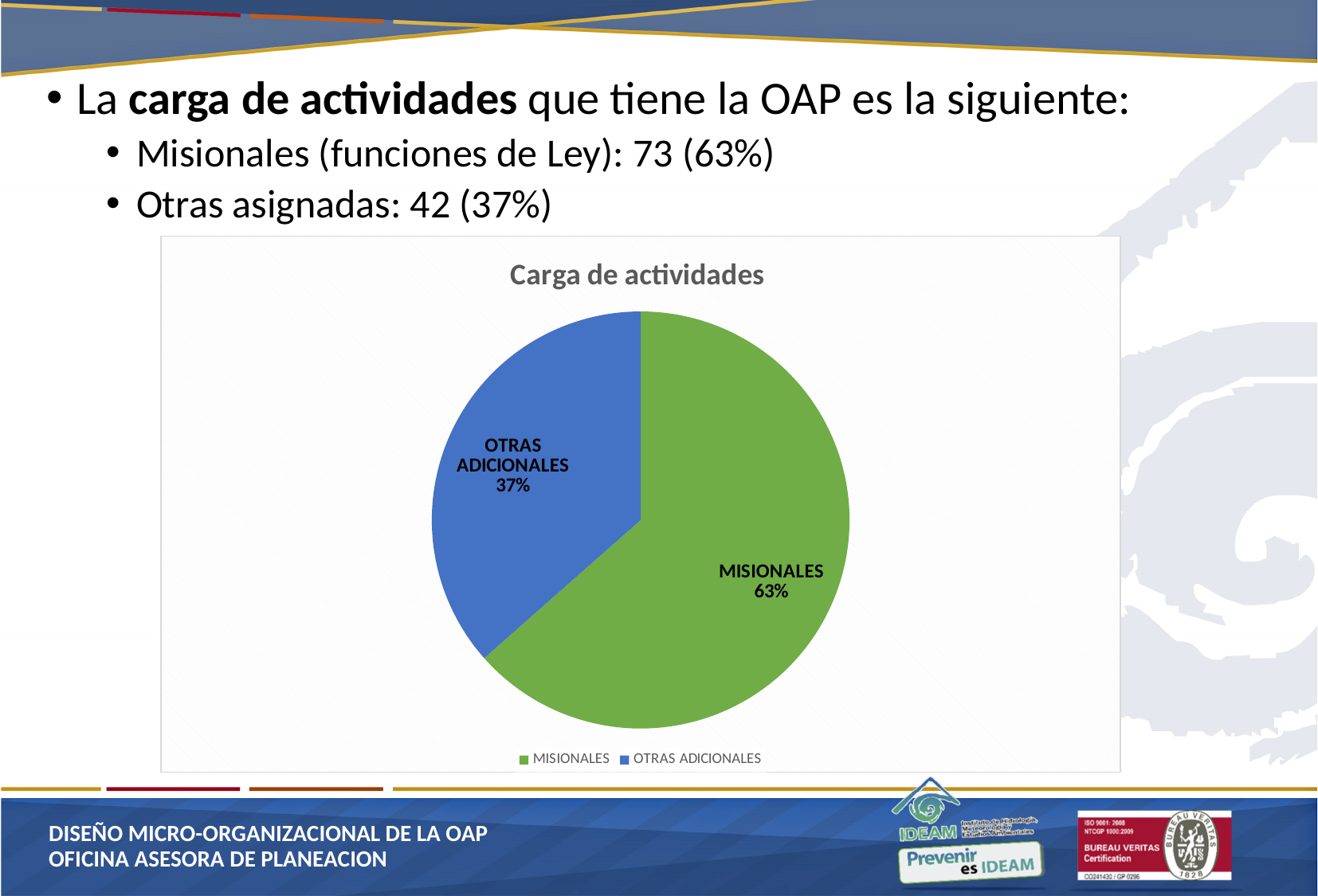
How many entries does the legend list? 2 What is the title of the chart? Carga de actividades Which is larger, the MISIONALES slice or the OTRAS ADICIONALES slice? MISIONALES What colour is the MISIONALES slice? green What type of chart is shown on the slide? pie chart Which slice is the largest in the pie chart? MISIONALES Which slice is the smallest in the pie chart? OTRAS ADICIONALES What is the difference in percentage points between the MISIONALES and OTRAS ADICIONALES slices? 26% How many slices does the pie chart have? 2 What percentage share does the OTRAS ADICIONALES slice have? 37% What percentage share does the MISIONALES slice have? 63%